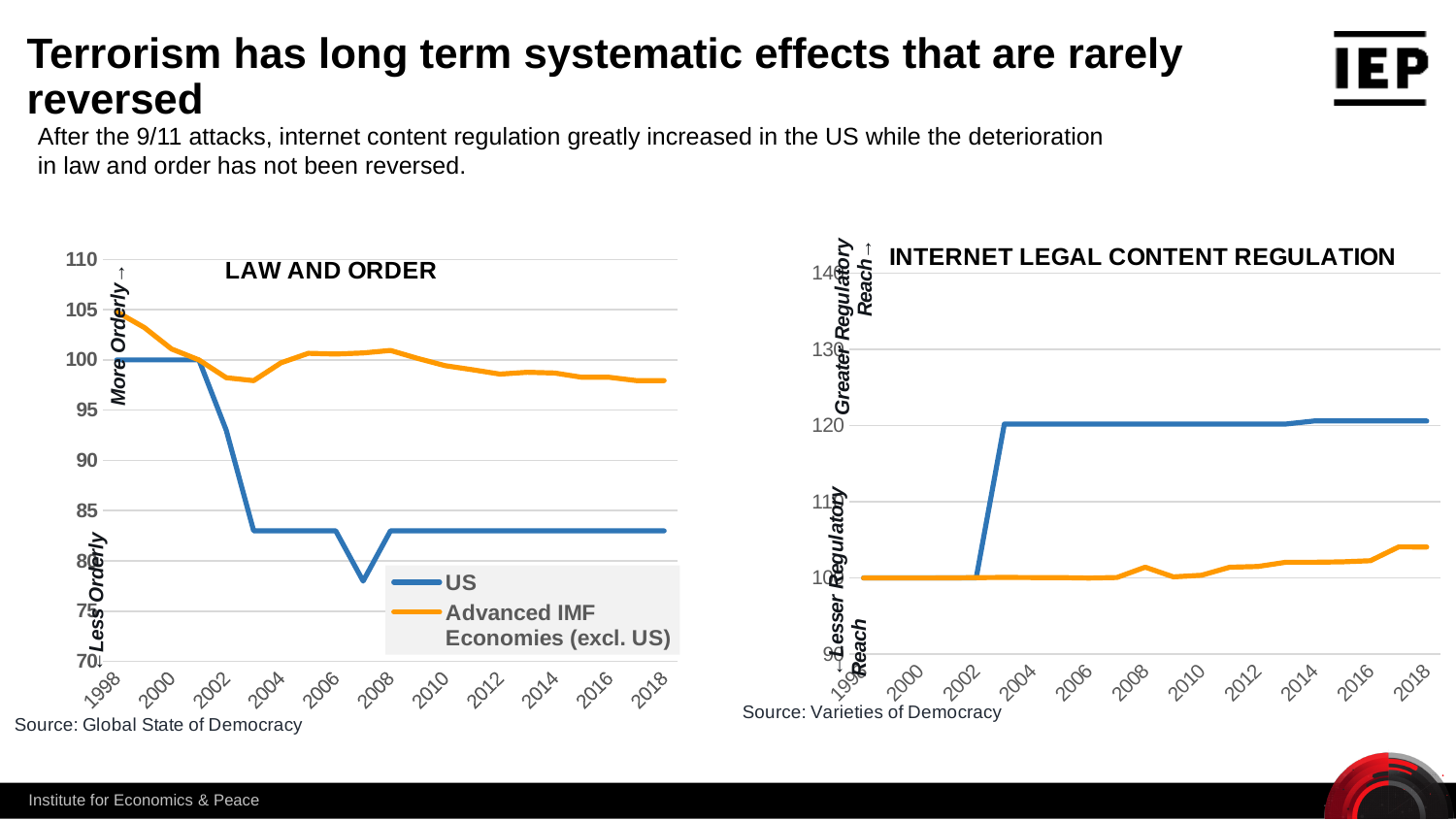
In the INTERNET LEGAL CONTENT REGULATION chart, is the US value in 2010 greater or less than 110? greater What is the title of the chart on the right side of the slide? INTERNET LEGAL CONTENT REGULATION In the INTERNET LEGAL CONTENT REGULATION chart, is the Advanced IMF Economies (excl. US) value in 2006 greater or less than 110? less What kind of chart is the LAW AND ORDER chart? line chart How many series does the legend of the LAW AND ORDER chart list? 2 In the LAW AND ORDER chart, is the Advanced IMF Economies (excl. US) value in 2010 greater or less than 95? greater In the INTERNET LEGAL CONTENT REGULATION chart, does the US series rise or fall between 2002 and 2004? rise In the LAW AND ORDER chart, does the US series rise or fall between 2002 and 2004? fall What source is cited below the LAW AND ORDER chart? Global State of Democracy In the LAW AND ORDER chart, which series has the higher value in 2016, US or Advanced IMF Economies (excl. US)? Advanced IMF Economies (excl. US) In the INTERNET LEGAL CONTENT REGULATION chart, which series has the higher value in 2014, US or Advanced IMF Economies (excl. US)? US